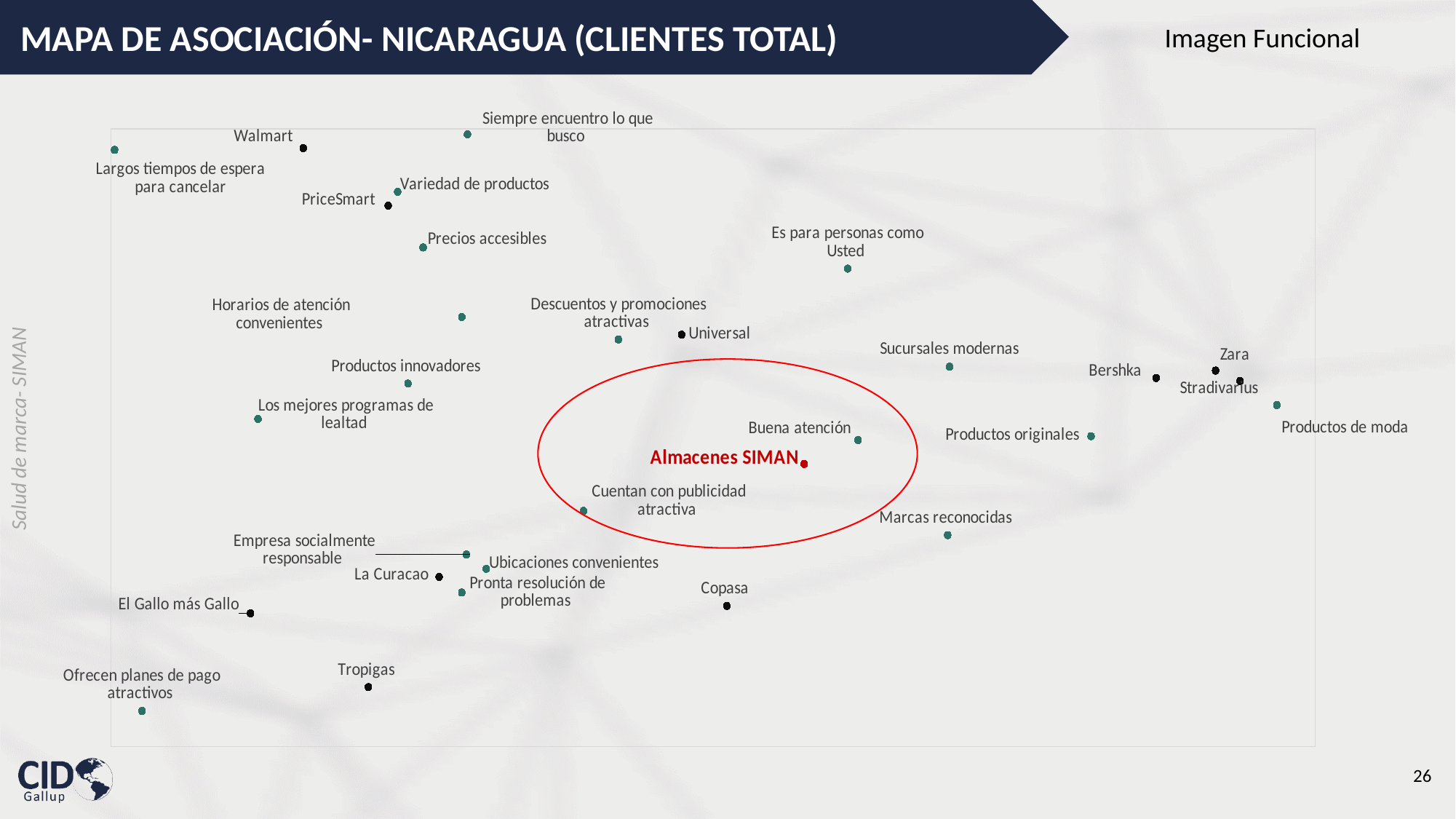
Which brand is plotted closest to 'Ubicaciones convenientes'? La Curacao Which brand is highlighted in red and enclosed by the red ellipse? Almacenes SIMAN What kind of chart is shown on the slide? Scatter chart (association map) Which brand is plotted closest to the attribute 'Precios accesibles'? PriceSmart Which attribute is plotted closest to Walmart? Variedad de productos Which brand is positioned lowest on the map? Tropigas What is the title of the chart? MAPA DE ASOCIACIÓN- NICARAGUA (CLIENTES TOTAL) How many brands (black or red points) are plotted on the map? 11 Which attributes appear inside the red ellipse together with Almacenes SIMAN? Buena atención and Cuentan con publicidad atractiva Which brand is plotted closest to the attribute 'Productos de moda'? Stradivarius Which attribute is positioned in the top-left corner of the map? Largos tiempos de espera para cancelar Which brand is plotted closest to 'Descuentos y promociones atractivas'? Universal